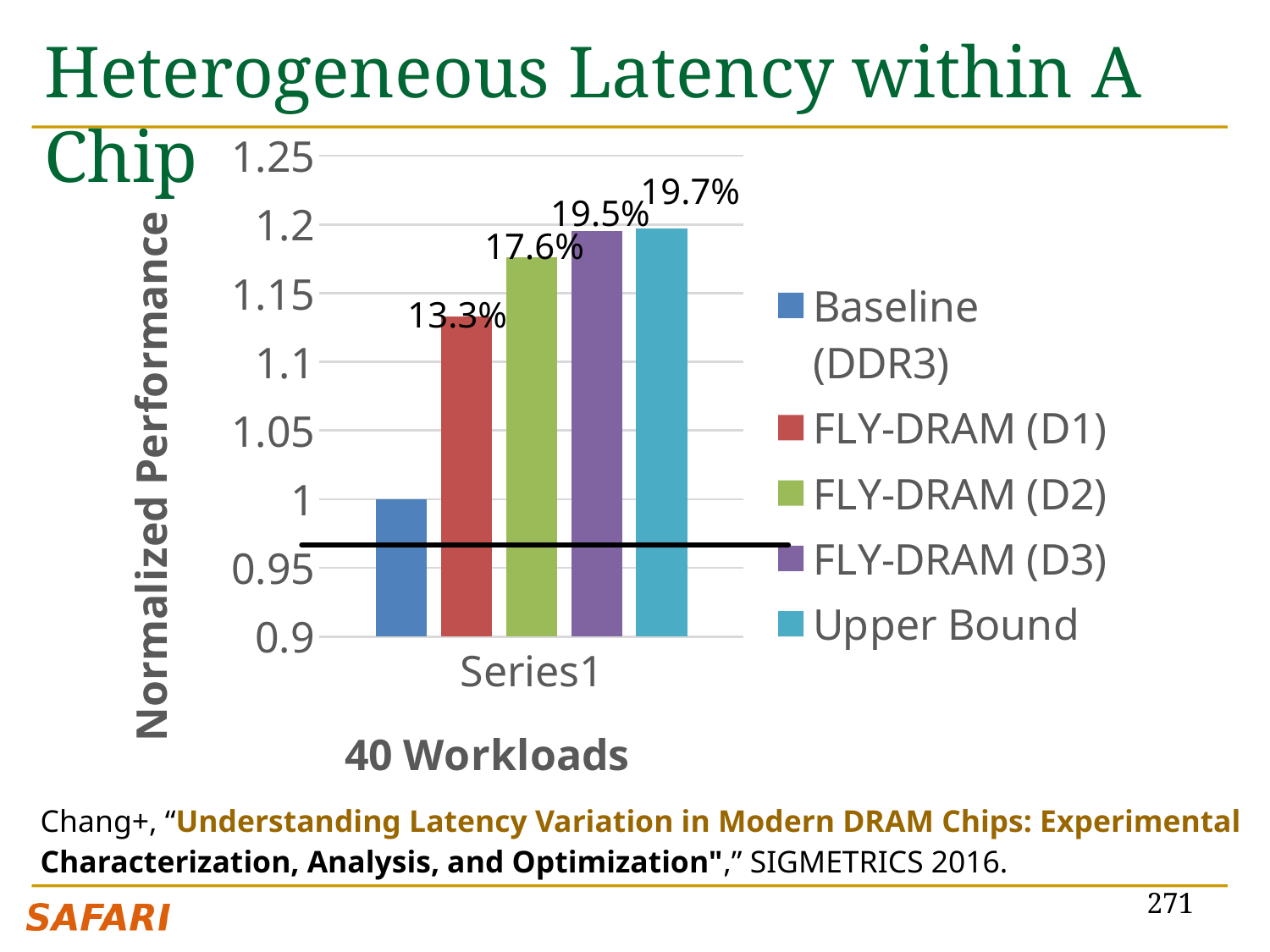
Which bar is taller, FLY-DRAM (D1) or FLY-DRAM (D2)? FLY-DRAM (D2) Which series has the tallest bar? Upper Bound What is the data label shown on the FLY-DRAM (D1) bar? 13.3% What is the data label shown on the FLY-DRAM (D2) bar? 17.6% Which series has the shortest bar? Baseline (DDR3) What is the title of the vertical axis? Normalized Performance What is the data label shown on the Upper Bound bar? 19.7% What kind of chart is shown on the slide? bar chart How many series does the legend list? 5 What normalized performance value does the Baseline (DDR3) bar reach? 1 What is the data label shown on the FLY-DRAM (D3) bar? 19.5% Is the normalized performance for FLY-DRAM (D1) greater or less than 1.1? greater